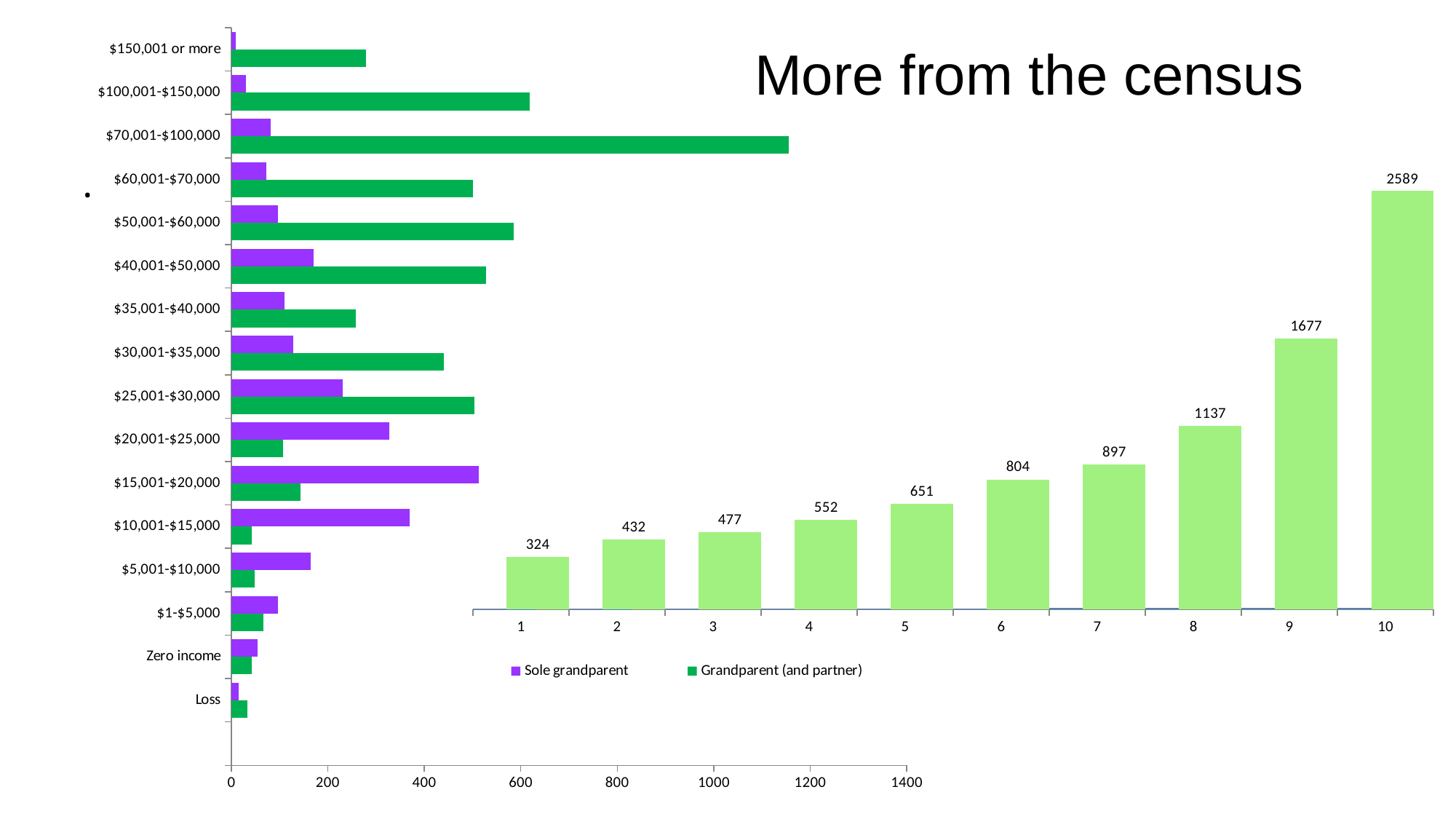
On the right-hand chart, how many bars are plotted? 10 On the right-hand chart, what is the value for category 5? 651 On the left-hand chart, for $20,001-$25,000, which series has the larger value: Sole grandparent or Grandparent (and partner)? Sole grandparent On the left-hand chart, how many series does the legend list? 2 On the right-hand chart, which category has the lowest value? 1 On the left-hand chart, which income category has the highest Grandparent (and partner) value? $70,001-$100,000 On the right-hand chart, what is the difference between the values for categories 10 and 9? 912 On the right-hand chart, do the values rise or fall from category 1 to category 10? rise On the right-hand chart, what is the value for category 10? 2589 On the left-hand chart, is the Grandparent (and partner) value for $70,001-$100,000 greater or less than 1000? greater What kind of chart is the left-hand chart? bar chart On the right-hand chart, which category has the highest value? 10